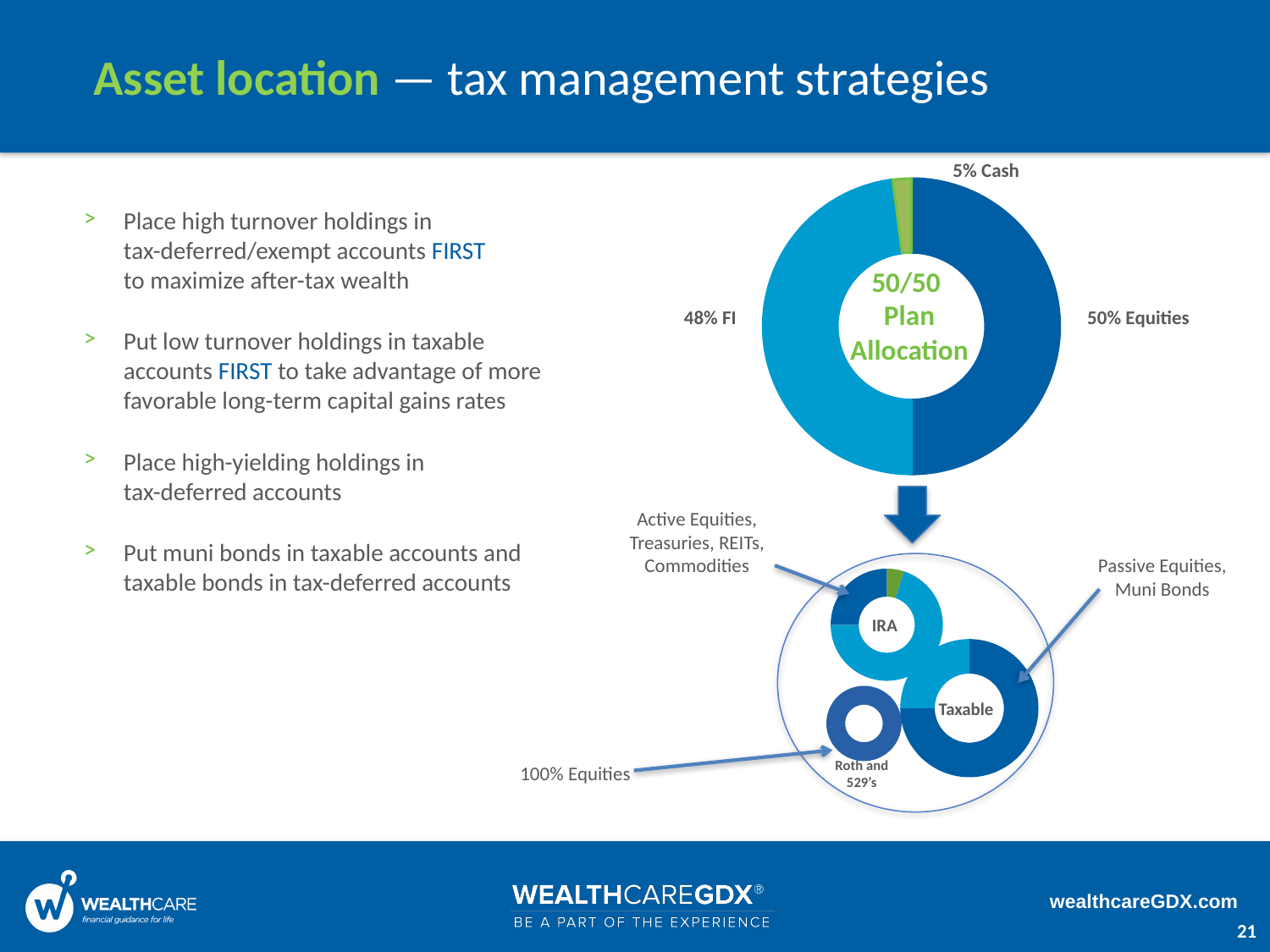
In the 50/50 Plan Allocation donut chart, which segment is the smallest? Cash How many segments does the 50/50 Plan Allocation donut chart have? 3 In the 50/50 Plan Allocation donut chart, what share is labeled for Cash? 5% Cash What kind of chart is the 50/50 Plan Allocation chart at the top right of the slide? Donut (pie) chart In the 50/50 Plan Allocation donut chart, what share is labeled for Equities? 50% Equities What text appears in the center of the large donut chart on the slide? 50/50 Plan Allocation What are the labels of the three small donut charts inside the circle at the bottom right of the slide? IRA, Taxable, Roth and 529's In the 50/50 Plan Allocation donut chart, what is the difference between the FI share and the Cash share? 43% In the 50/50 Plan Allocation donut chart, what is the difference between the Equities share and the FI share? 2% In the 50/50 Plan Allocation donut chart, what share is labeled for FI? 48% FI In the 50/50 Plan Allocation donut chart, which segment is the largest? Equities In the 50/50 Plan Allocation donut chart, which is larger, the Equities share or the Cash share? Equities